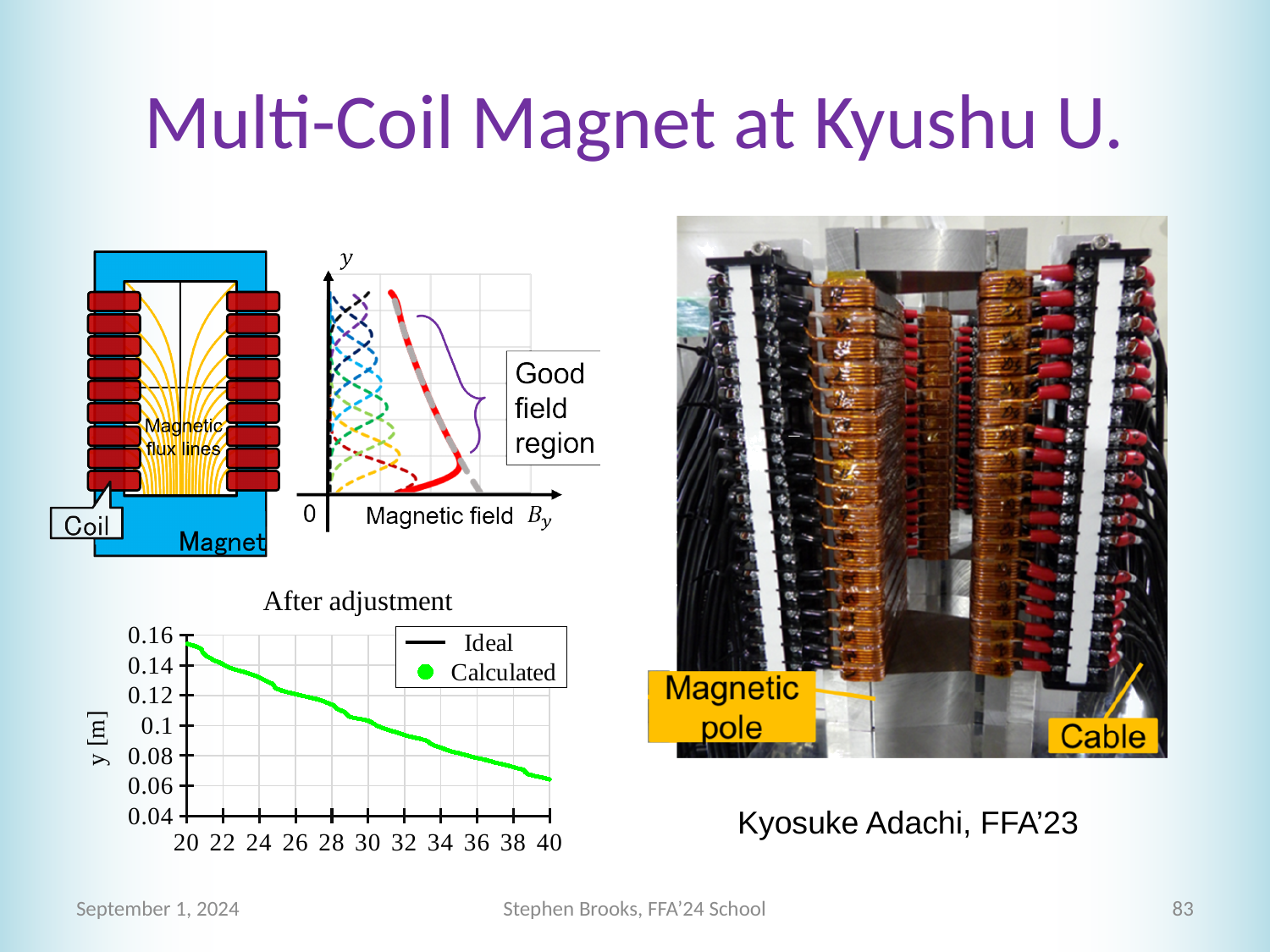
In the 'After adjustment' chart, is the Calculated value at x = 20 greater or less than 0.14? greater What kind of chart is the 'After adjustment' chart? line chart In the 'After adjustment' chart, how many series does the legend list? 2 In the 'After adjustment' chart, do the plotted values rise or fall as the x value increases from 20 to 40? fall In the 'After adjustment' chart, at which x value is the Calculated value highest? 20 In the 'After adjustment' chart, is the Calculated value at x = 28 greater or less than 0.1? greater In the 'After adjustment' chart, is the Calculated value at x = 40 greater or less than 0.08? less What is the title of the chart in the lower left of the slide? After adjustment In the 'After adjustment' chart, at which x value is the Calculated value lowest? 40 In the 'After adjustment' chart, which has the larger Calculated value, x = 20 or x = 40? x = 20 In the 'After adjustment' chart, what are the two legend entries? Ideal and Calculated